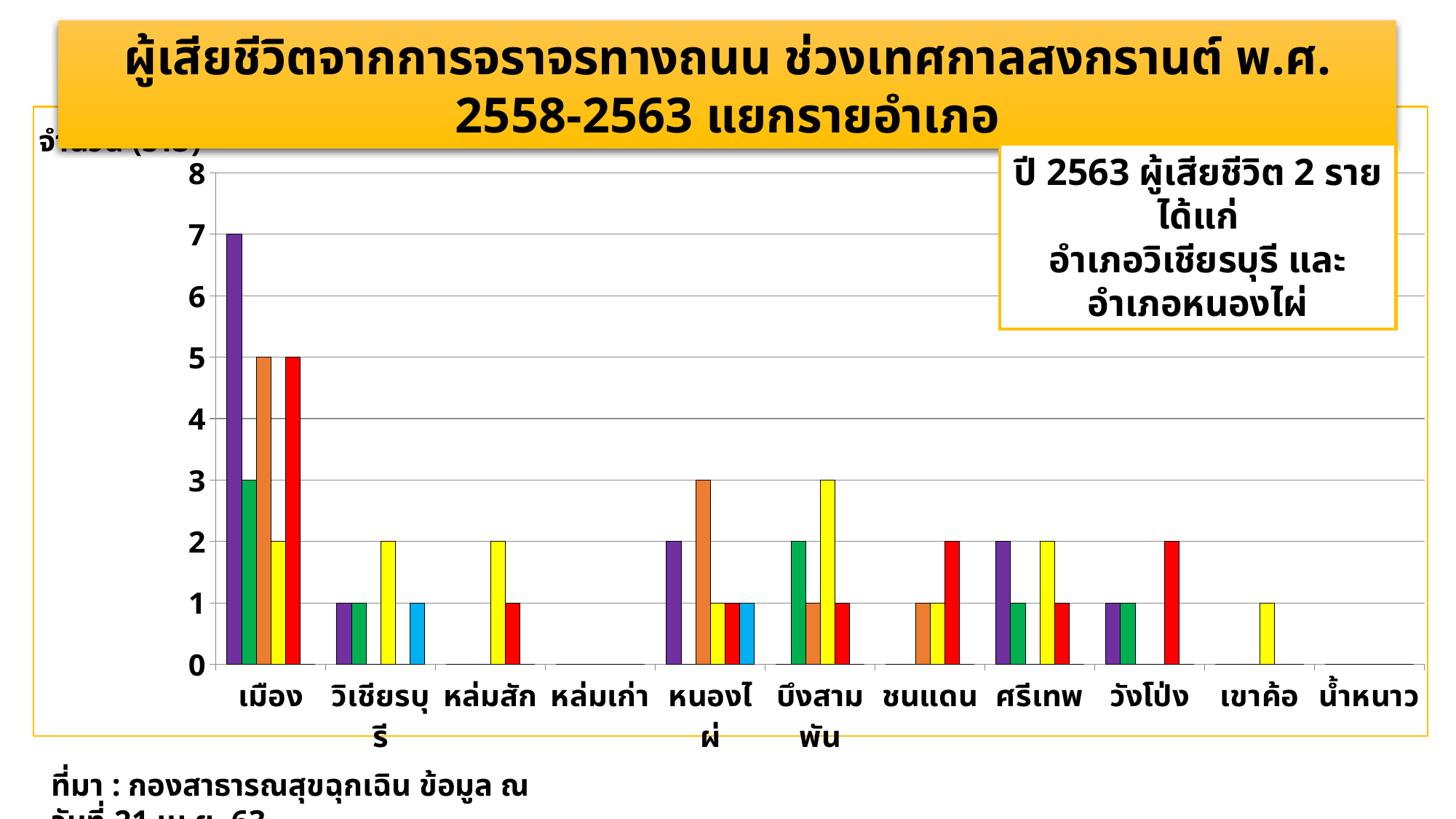
Which district has the tallest bar in the chart? เมือง Which districts have no bars at all in the chart? หล่มเก่า and น้ำหนาว What value does the orange bar for หนองไผ่ reach? 3 What value does the yellow bar for บึงสามพัน reach? 3 Which is larger, the purple bar for เมือง or the purple bar for หนองไผ่? เมือง What value does the tallest bar (purple, for เมือง) reach on the y axis? 7 What kind of chart is shown on the slide? bar chart How many different bar colours (series) appear in the chart? 6 What is the highest tick value shown on the y axis? 8 Is the purple bar for เมือง greater or less than 5? greater What value does the yellow bar for เขาค้อ reach? 1 How many districts (categories) are shown along the x axis? 11